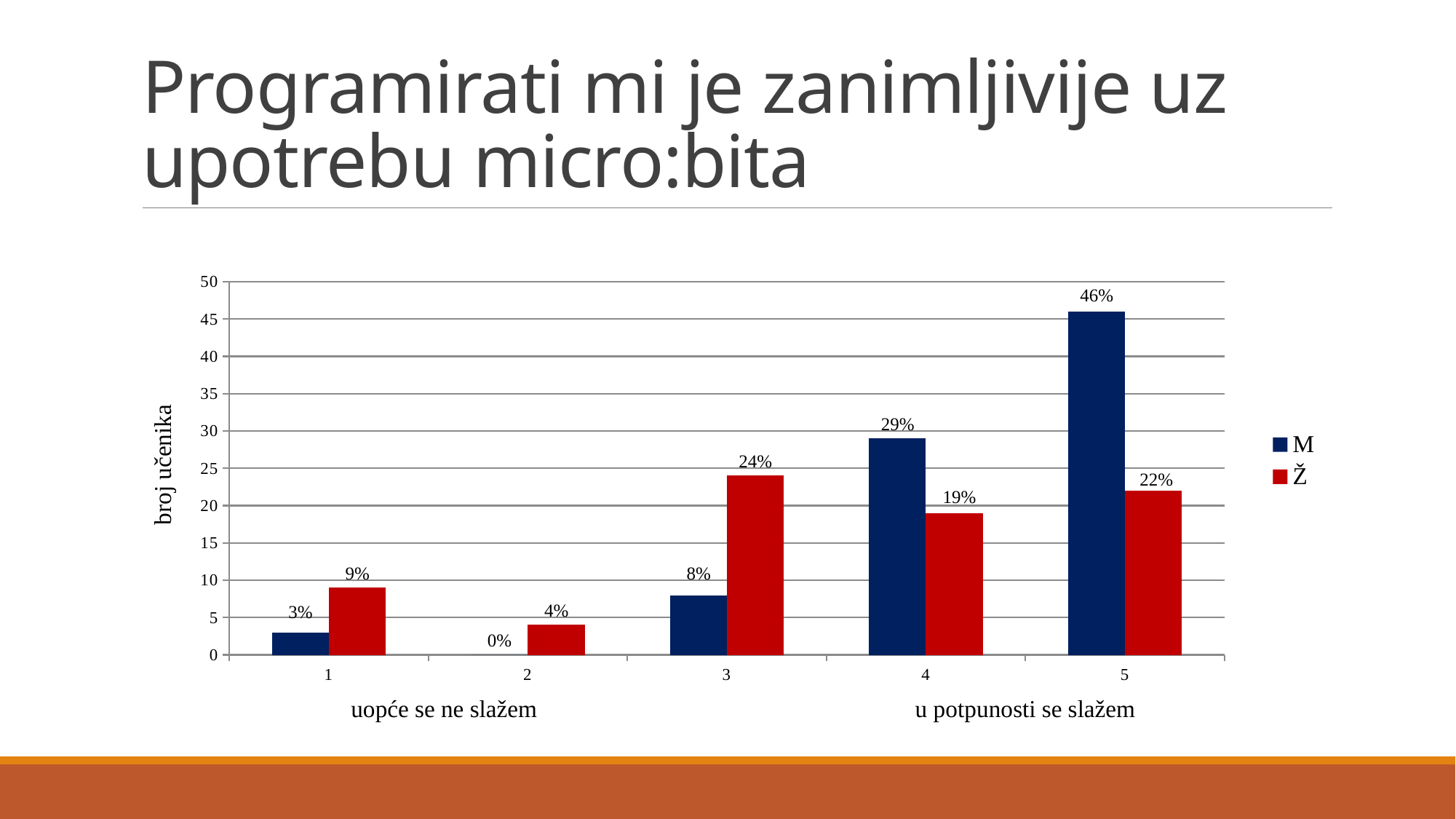
What is the data label for series Ž at category 3? 24% What is the data label for series M at category 2? 0% At category 3, which series has the larger value, M or Ž? Ž What is the label of the vertical axis? broj učenika What kind of chart is shown on the slide? bar chart What is the data label for series M at category 5? 46% How many series does the legend list? 2 Which category has the highest value for series M? 5 What is the data label for series Ž at category 1? 9% Which category has the lowest value for series Ž? 2 How many categories are shown on the x axis? 5 What is the difference between the M and Ž values at category 5? 24%